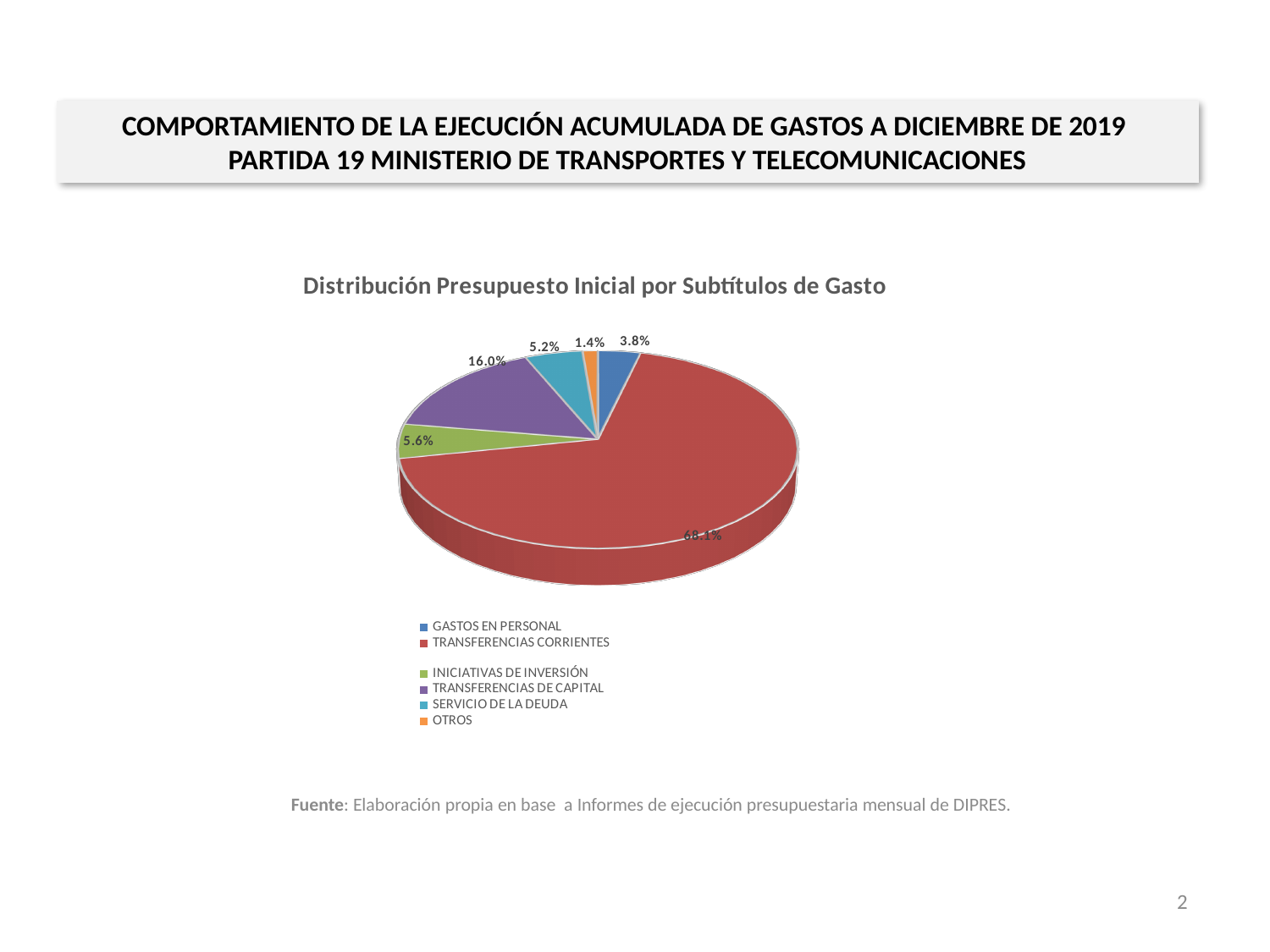
What is the value shown for INICIATIVAS DE INVERSIÓN? 5.6% What is the value shown for GASTOS EN PERSONAL? 3.8% What is the difference between the shares of TRANSFERENCIAS CORRIENTES and TRANSFERENCIAS DE CAPITAL? 52.1% Which category has the largest slice of the pie? TRANSFERENCIAS CORRIENTES What is the value shown for OTROS? 1.4% What is the title of the chart? Distribución Presupuesto Inicial por Subtítulos de Gasto Which category has the smallest slice of the pie? OTROS How many categories does the legend list? 6 What kind of chart is shown on the slide? Pie chart What share of the pie does TRANSFERENCIAS DE CAPITAL represent? 16.0% What is the value shown for SERVICIO DE LA DEUDA? 5.2% What share of the pie does TRANSFERENCIAS CORRIENTES represent? 68.1%